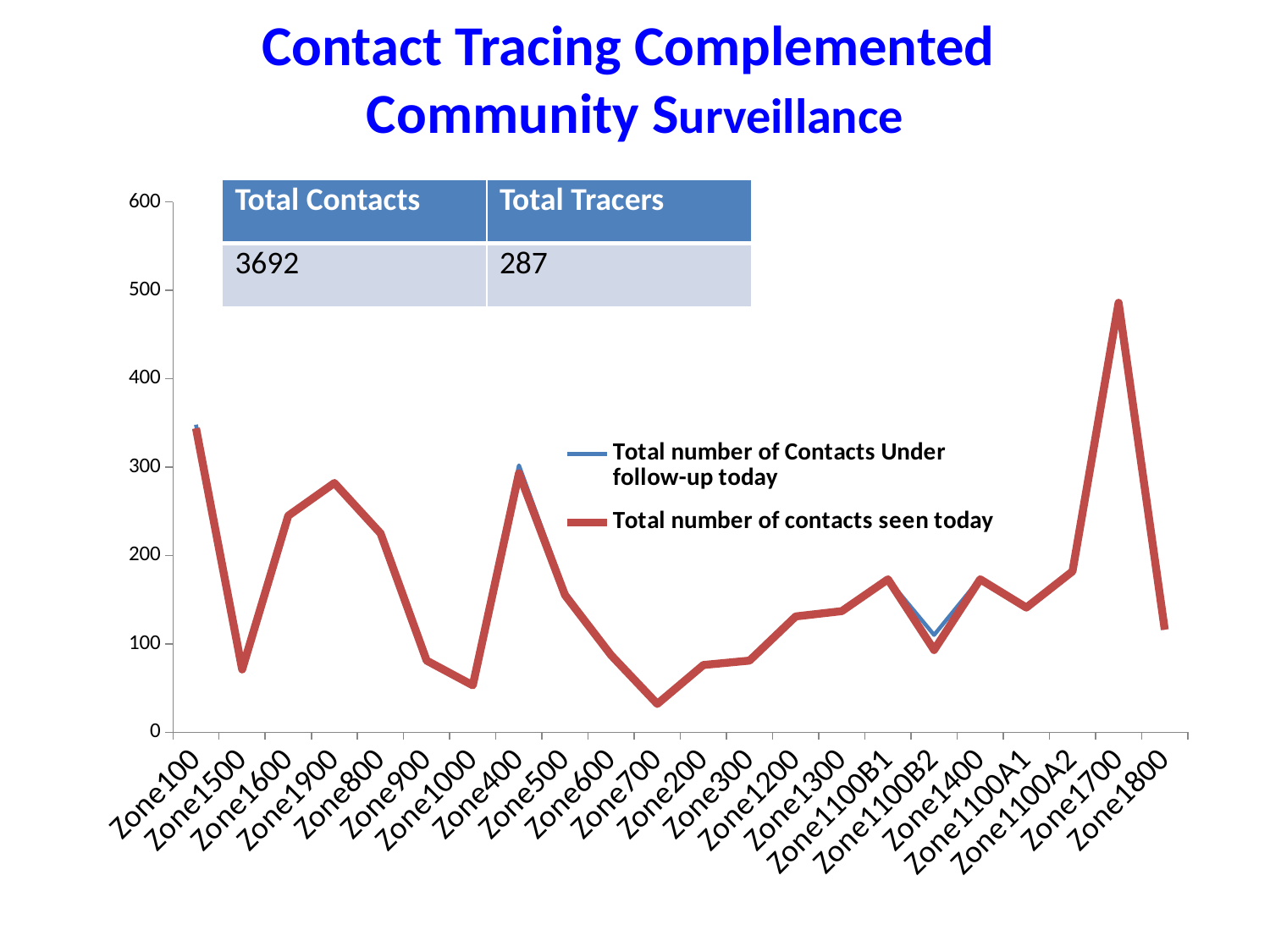
Which zone has the lowest number of contacts seen today? Zone700 What is the name of the series drawn in red on the chart? Total number of contacts seen today How many series does the chart legend list? 2 Is the value for Zone1000 for contacts seen today greater or less than 100? less Is the value for Zone1700 for contacts seen today greater or less than 400? greater Which zone has a higher number of contacts seen today, Zone1600 or Zone500? Zone1600 What kind of chart is shown on the slide? line chart How many zones are plotted along the x axis of the chart? 22 Is the value for Zone100 for contacts seen today greater or less than 300? greater Which zone has the highest number of contacts seen today? Zone1700 Do the values for contacts seen today rise or fall from Zone700 to Zone1100B1? rise